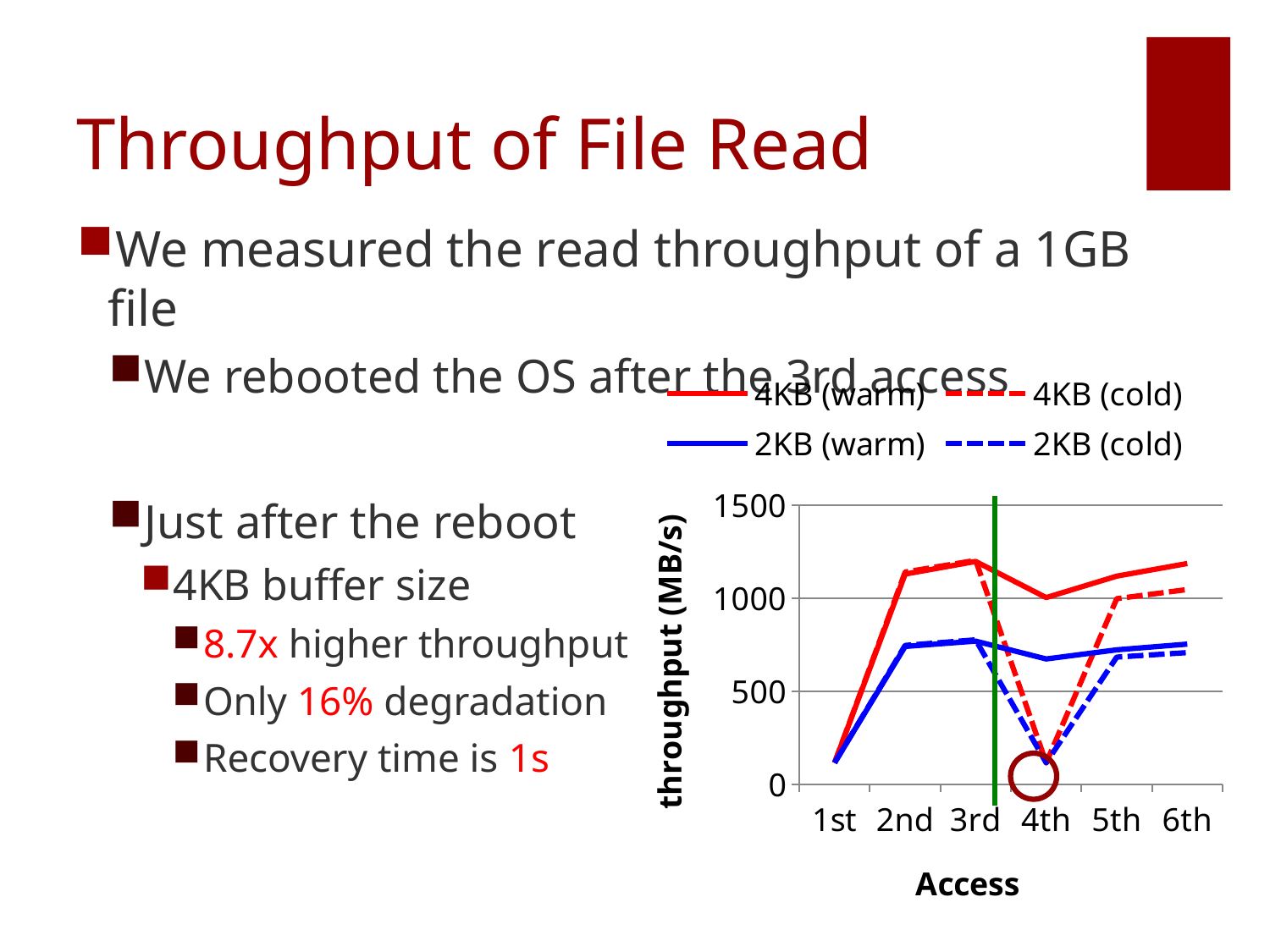
Is the value for 2KB (cold) at the 4th access greater or less than 500? less Is the value for 4KB (cold) at the 4th access greater or less than 500? less Is the value for 2KB (warm) at the 3rd access greater or less than 1000? less What kind of chart is shown on the slide? line chart How many access points are shown along the x axis of the chart? 6 Does the 4KB (cold) series rise or fall from the 3rd access to the 4th access? fall At the 6th access, which series has the higher value: 4KB (warm) or 2KB (warm)? 4KB (warm) At the 4th access, which series has the higher value: 4KB (warm) or 4KB (cold)? 4KB (warm) How many series does the chart legend list? 4 What is the title of the chart's y axis? throughput (MB/s)